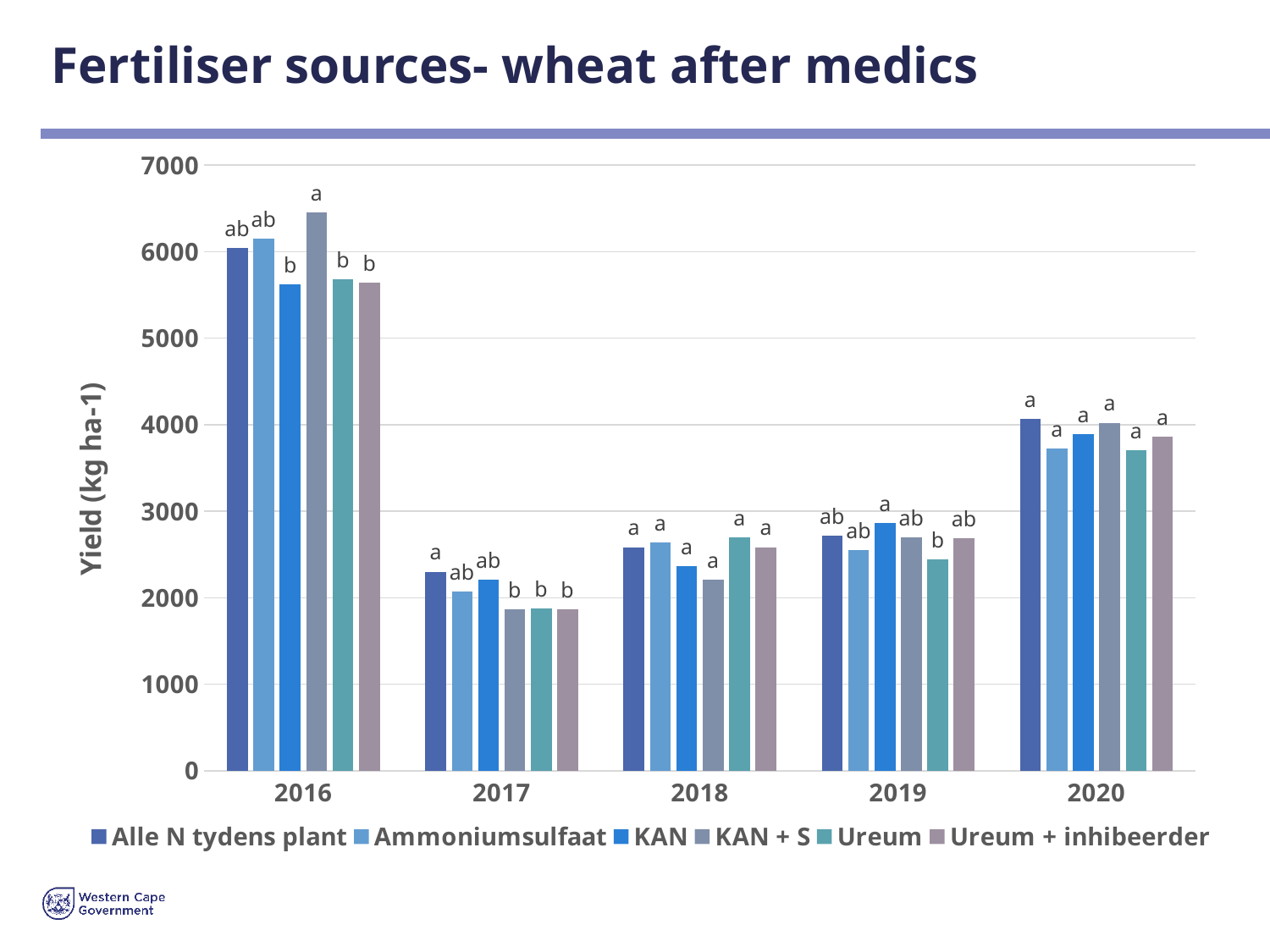
In 2016, which fertiliser source has the highest yield? KAN + S Is the yield for KAN + S in 2016 greater or less than 6000? greater How many fertiliser series does the legend list? 6 In 2019, which fertiliser source has the lowest yield? Ureum Is the yield for Ureum in 2020 greater or less than 4000? less Which year shows the lowest yields across all fertiliser sources? 2017 Which is larger: the yield for Alle N tydens plant in 2016 or in 2017? 2016 In 2019, which fertiliser source has the highest yield? KAN How many years are shown on the x axis? 5 What is the label on the y axis? Yield (kg ha-1) Is the yield for KAN in 2016 greater or less than 6000? less What kind of chart is shown on the slide? bar chart